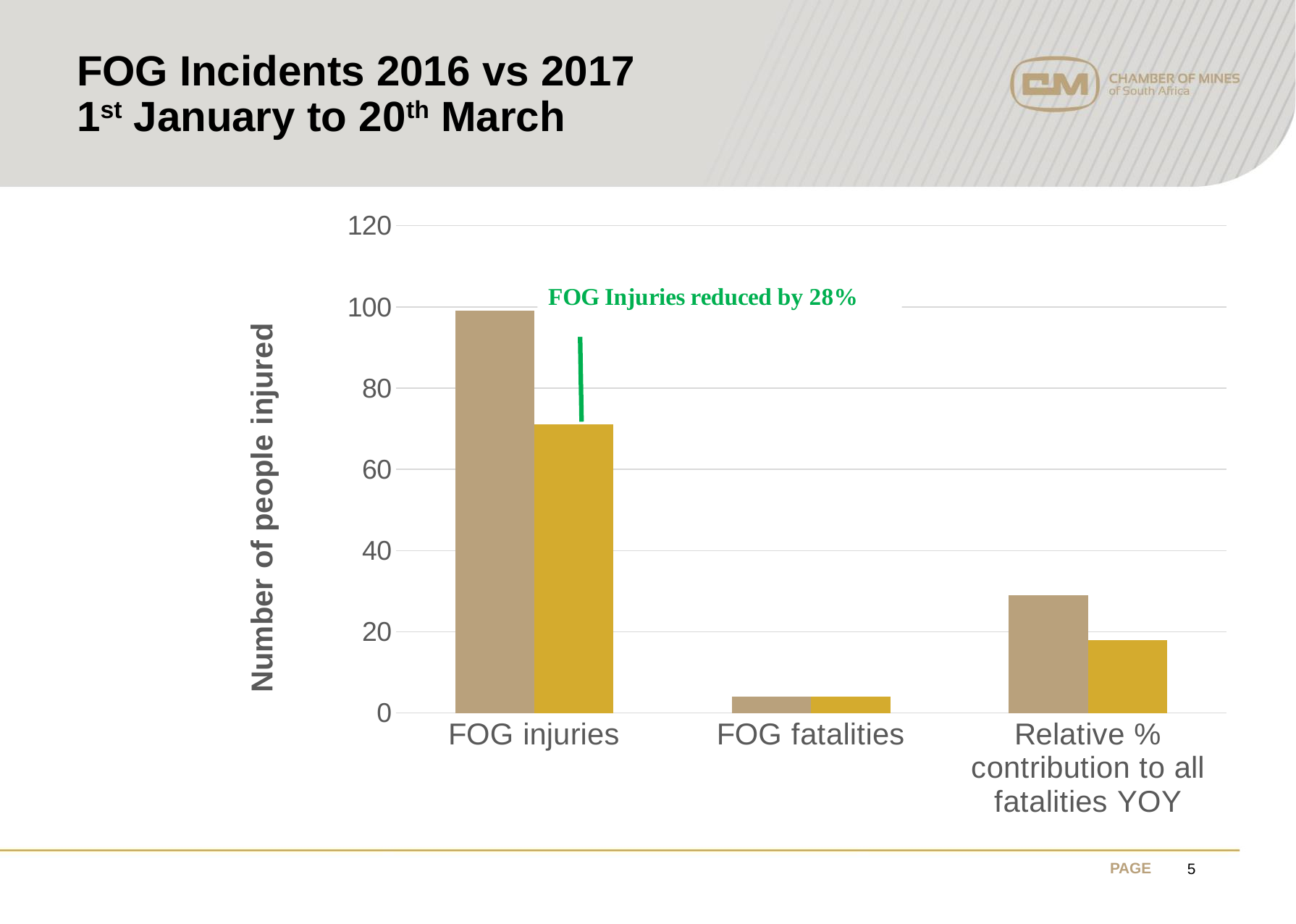
For Relative % contribution to all fatalities YOY, which bar is taller, the left (tan) bar or the right (gold) bar? the left (tan) bar Is the value of the left (tan) bar for Relative % contribution to all fatalities YOY greater or less than 20? greater Which category has the tallest bars in the chart? FOG injuries What kind of chart is shown on the slide? bar chart What is the title of the y axis of the chart? Number of people injured What does the green annotation on the chart say? FOG Injuries reduced by 28% Which category has the shortest bars in the chart? FOG fatalities Is the value of the left (tan) bar for FOG injuries greater or less than 80? greater How many categories are shown on the x axis of the chart? 3 For FOG injuries, which bar is taller, the left (tan) bar or the right (gold) bar? the left (tan) bar Is the value of the right (gold) bar for FOG injuries greater or less than 80? less